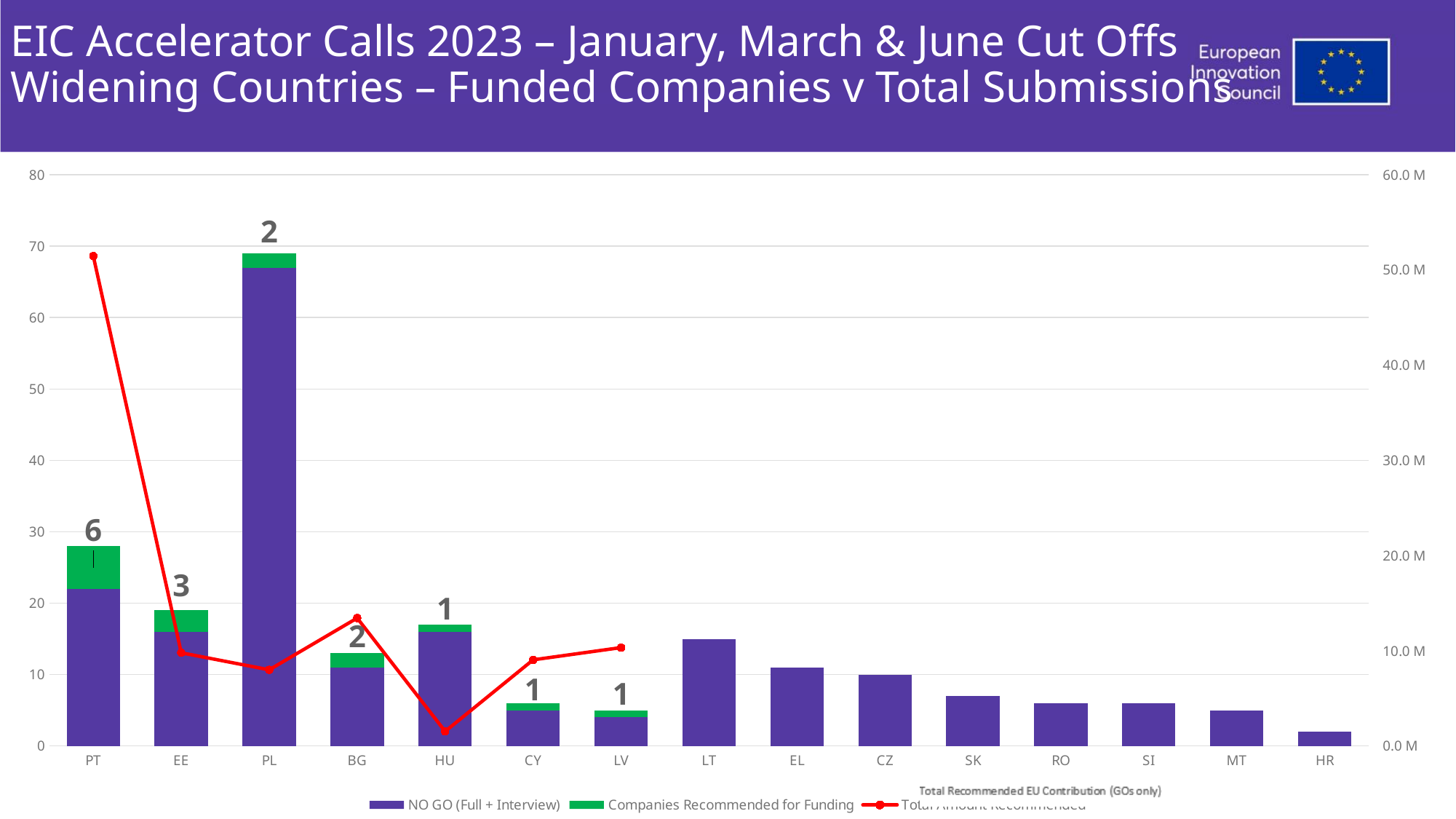
How many countries are shown on the x axis? 15 How many companies were recommended for funding for BG? 2 Is the total bar height for PL greater or less than 60? greater Which country has the highest number of companies recommended for funding? PT Which has more companies recommended for funding, PL or EE? EE Which country has the tallest bar overall (most total submissions)? PL How many companies were recommended for funding for PT? 6 How many companies were recommended for funding for EE? 3 How many series does the legend list? 3 Is the Total Amount Recommended for HU greater or less than 10.0 M? less What kind of chart is shown on the slide? bar chart with a line What is the difference between the number of companies recommended for funding for PT and for EE? 3